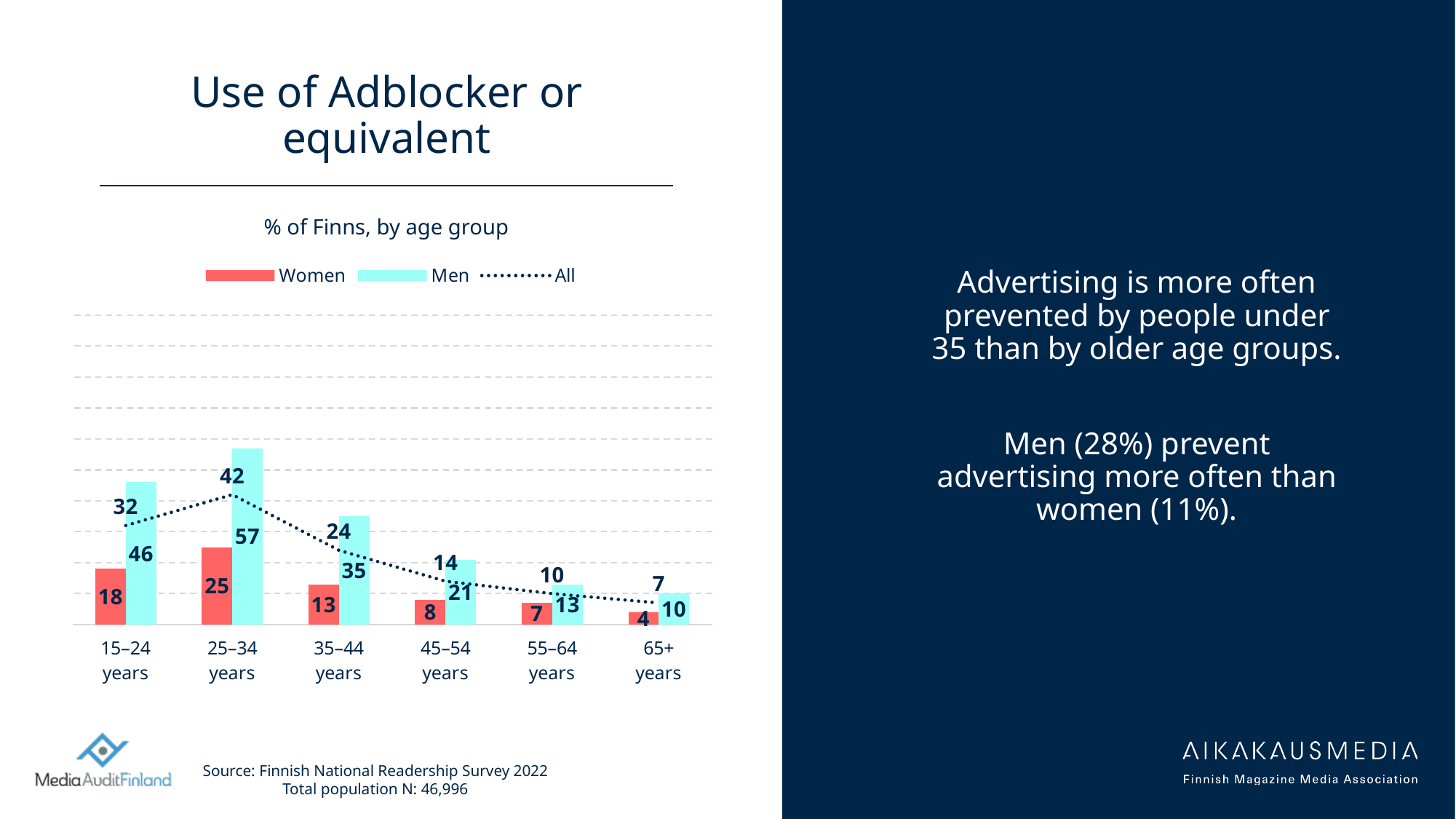
What is the difference between the men and women values in the 35–44 years age group? 22 How many age groups are shown on the x axis? 6 Which age group has the highest value for men? 25–34 years Which age group has the lowest value for women? 65+ years What percentage of men aged 25–34 years use an adblocker or equivalent? 57 What is the value for women in the 15–24 years age group? 18 Which series is shown as a dotted line? All From the 25–34 years group onward, do the values of the All series rise or fall as age increases? Fall Which is larger in the 55–64 years age group, the value for women or the value for men? Men What kind of chart is used to show the Women and Men series? Bar chart How many series does the legend list? 3 What is the value of the All series for the 45–54 years age group? 14